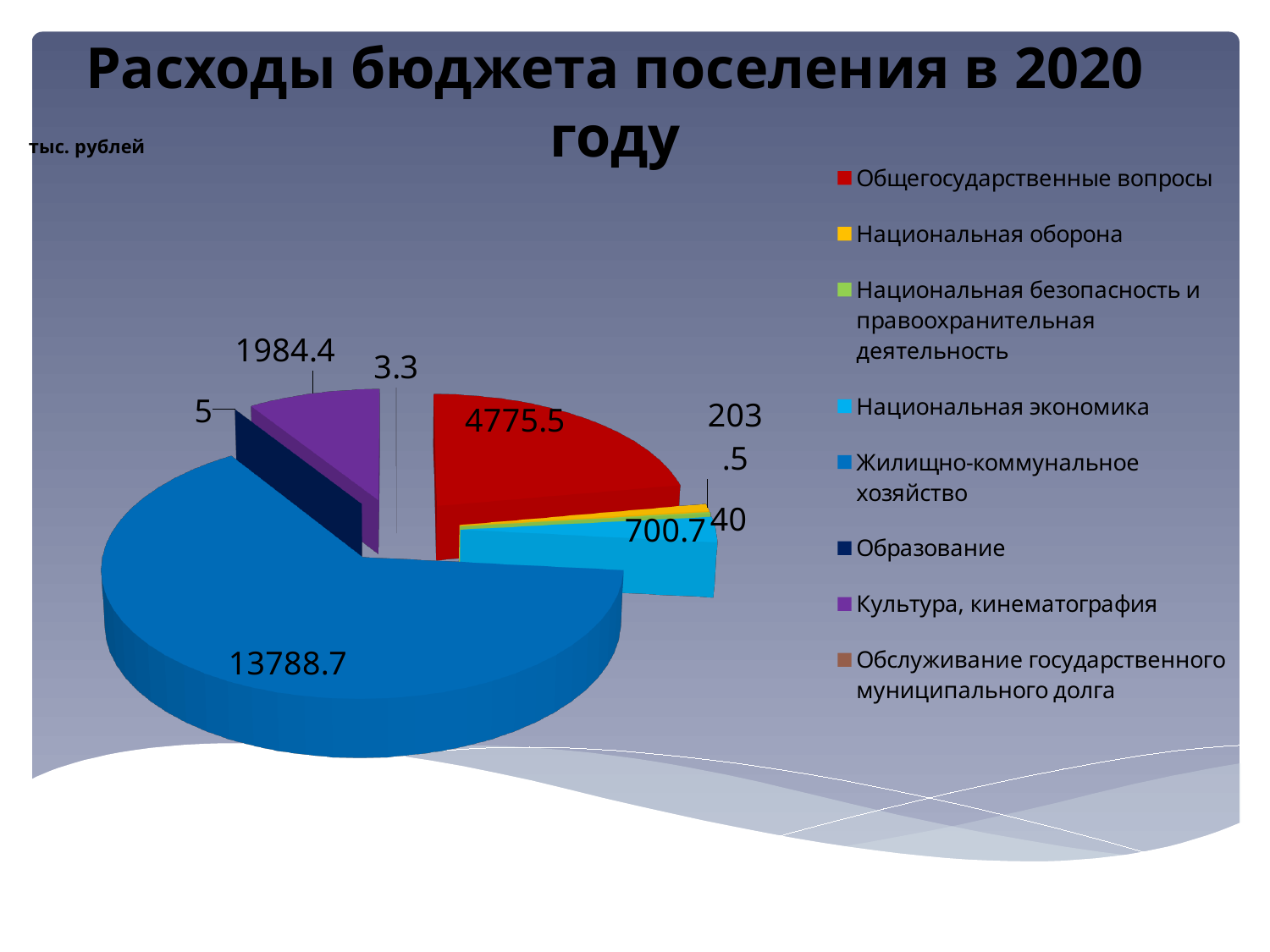
Which category has the smallest value? Обслуживание государственного муниципального долга What is the value for Жилищно-коммунальное хозяйство? 13788.7 What is the value for Образование? 5 What is the difference between the values for Жилищно-коммунальное хозяйство and Общегосударственные вопросы? 9013.2 What is the value for Национальная экономика? 700.7 What unit is indicated for the values on the chart? тыс. рублей Which is larger: Культура, кинематография or Национальная экономика? Культура, кинематография What type of chart is shown on the slide? pie chart What is the value for Общегосударственные вопросы? 4775.5 What is the value for Культура, кинематография? 1984.4 Which category has the largest share of the pie? Жилищно-коммунальное хозяйство How many categories does the legend list? 8